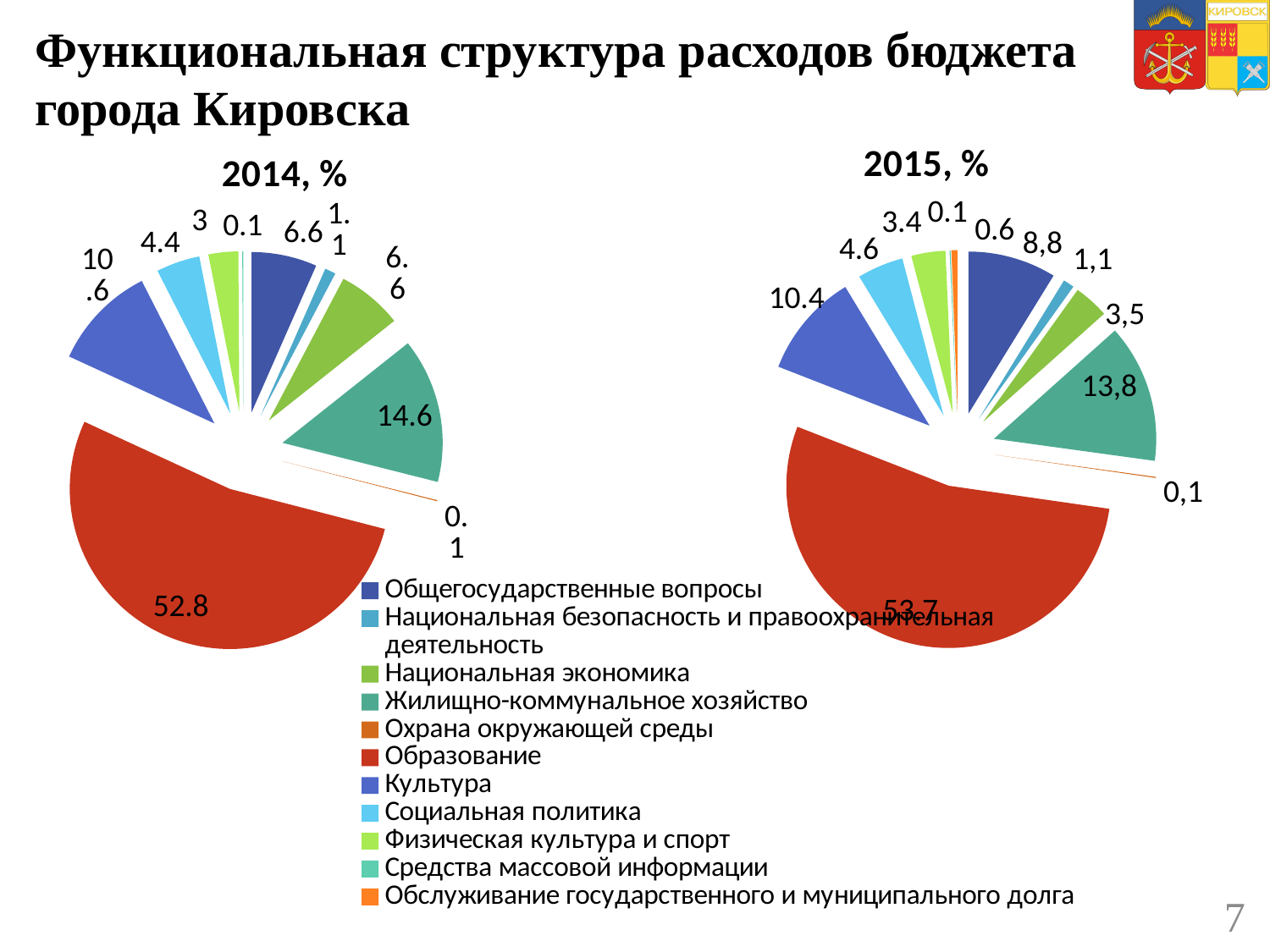
In the "2015, %" chart, what is the value for Образование? 53,7 In the "2014, %" chart, what is the value for Социальная политика? 4.4 How many categories does the legend list? 11 In the "2015, %" chart, what is the value for Жилищно-коммунальное хозяйство? 13,8 What kind of chart is used on this slide to show the budget expenditure structure? Pie chart In the "2015, %" chart, what is the difference between Общегосударственные вопросы and Национальная экономика? 5,3 What is the title of the left pie chart? 2014, % In the "2014, %" chart, what is the value for Жилищно-коммунальное хозяйство? 14.6 In the "2014, %" chart, what is the value for Образование? 52.8 In the "2014, %" chart, which is larger: Культура or Социальная политика? Культура In the "2015, %" chart, which category has the largest share? Образование In the "2015, %" chart, what is the value for Культура? 10,4